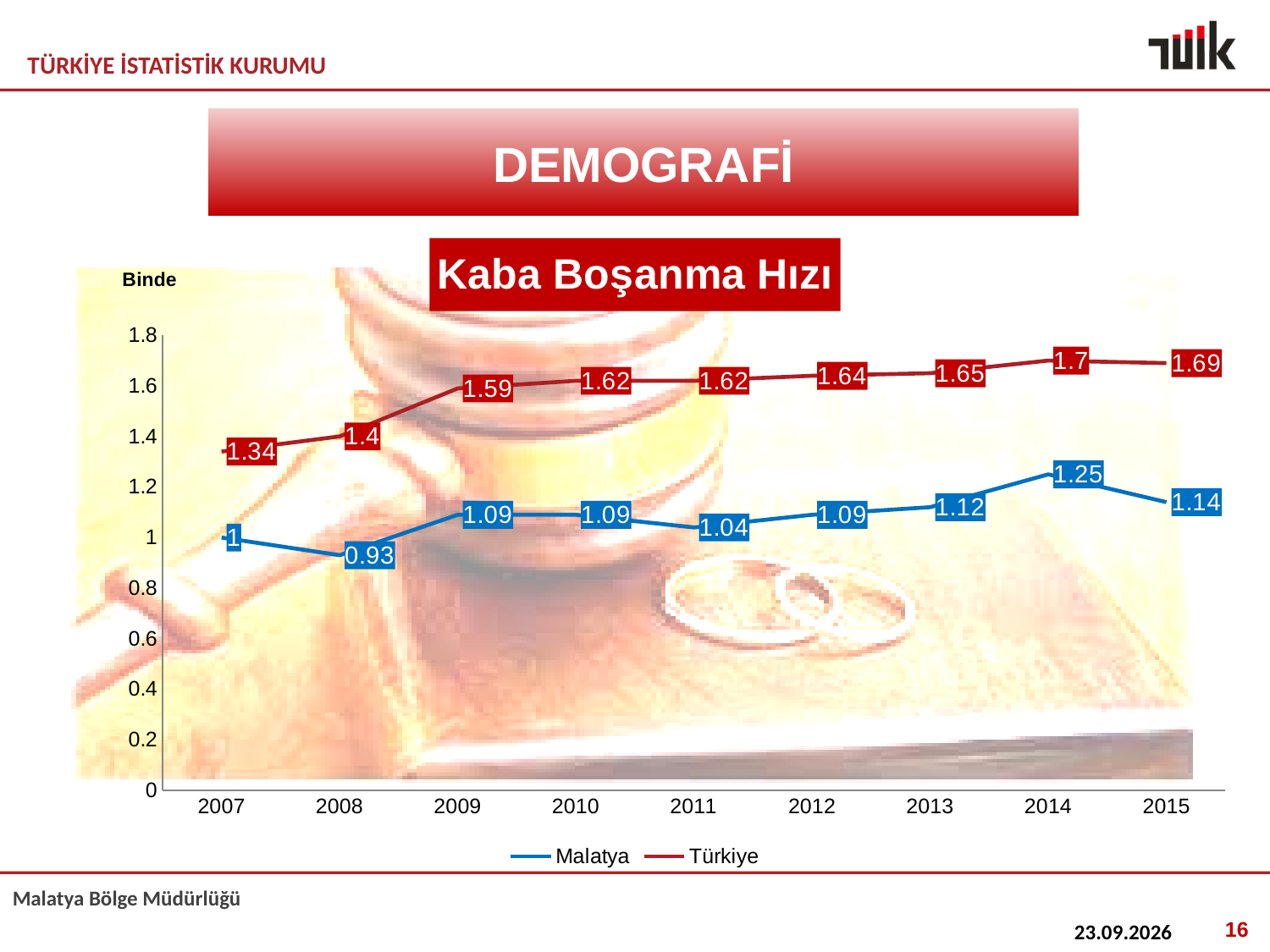
In which year is the Türkiye value lowest? 2007 What is the value for Malatya in 2008? 0.93 Does the Türkiye series generally rise or fall from 2007 to 2014? rise What is the value for Türkiye in 2014? 1.7 In which year is the Malatya value highest? 2014 How many years are shown on the x axis? 9 What type of chart is shown on the slide? line chart What is the value for Malatya in 2015? 1.14 How many series does the legend list? 2 What is the difference between the Türkiye and Malatya values in 2015? 0.55 Which series has the larger value in 2011, Malatya or Türkiye? Türkiye What is the title of the chart? Kaba Boşanma Hızı